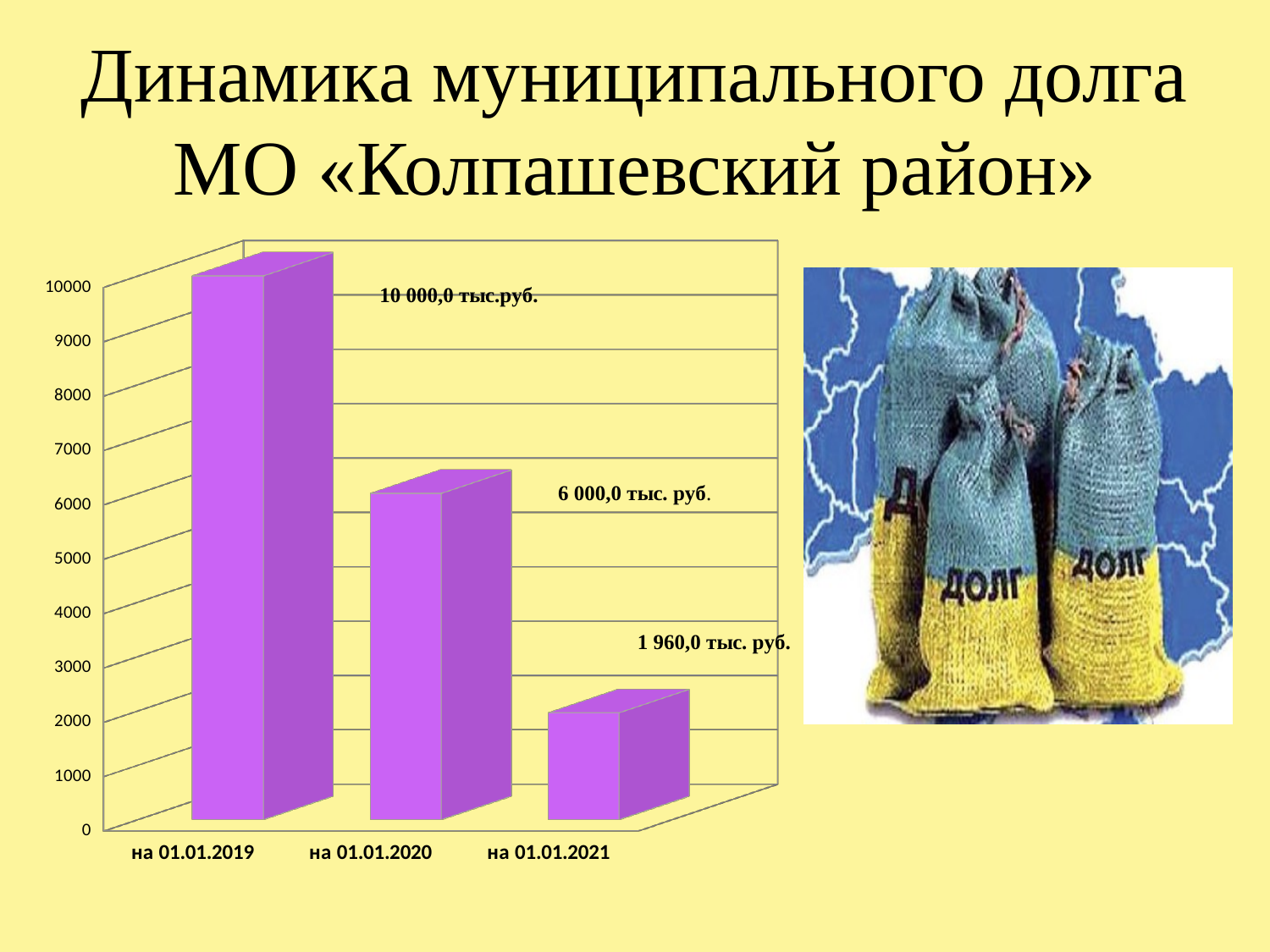
Which date has the lowest municipal debt? на 01.01.2021 What is the municipal debt value shown for на 01.01.2021? 1 960,0 тыс. руб. Is the value for на 01.01.2021 greater or less than 2000? less How many dates (categories) are shown on the chart? 3 What is the difference between the debt on 01.01.2020 and on 01.01.2021? 4 040,0 тыс. руб. Which is larger, the debt on 01.01.2020 or on 01.01.2021? на 01.01.2020 What is the municipal debt value shown for на 01.01.2020? 6 000,0 тыс. руб. What is the difference between the debt on 01.01.2019 and on 01.01.2020? 4 000,0 тыс. руб. What is the municipal debt value shown for на 01.01.2019? 10 000,0 тыс.руб. What kind of chart is shown on the slide? bar chart Do the values rise or fall from 01.01.2019 to 01.01.2021? fall Which date has the highest municipal debt? на 01.01.2019